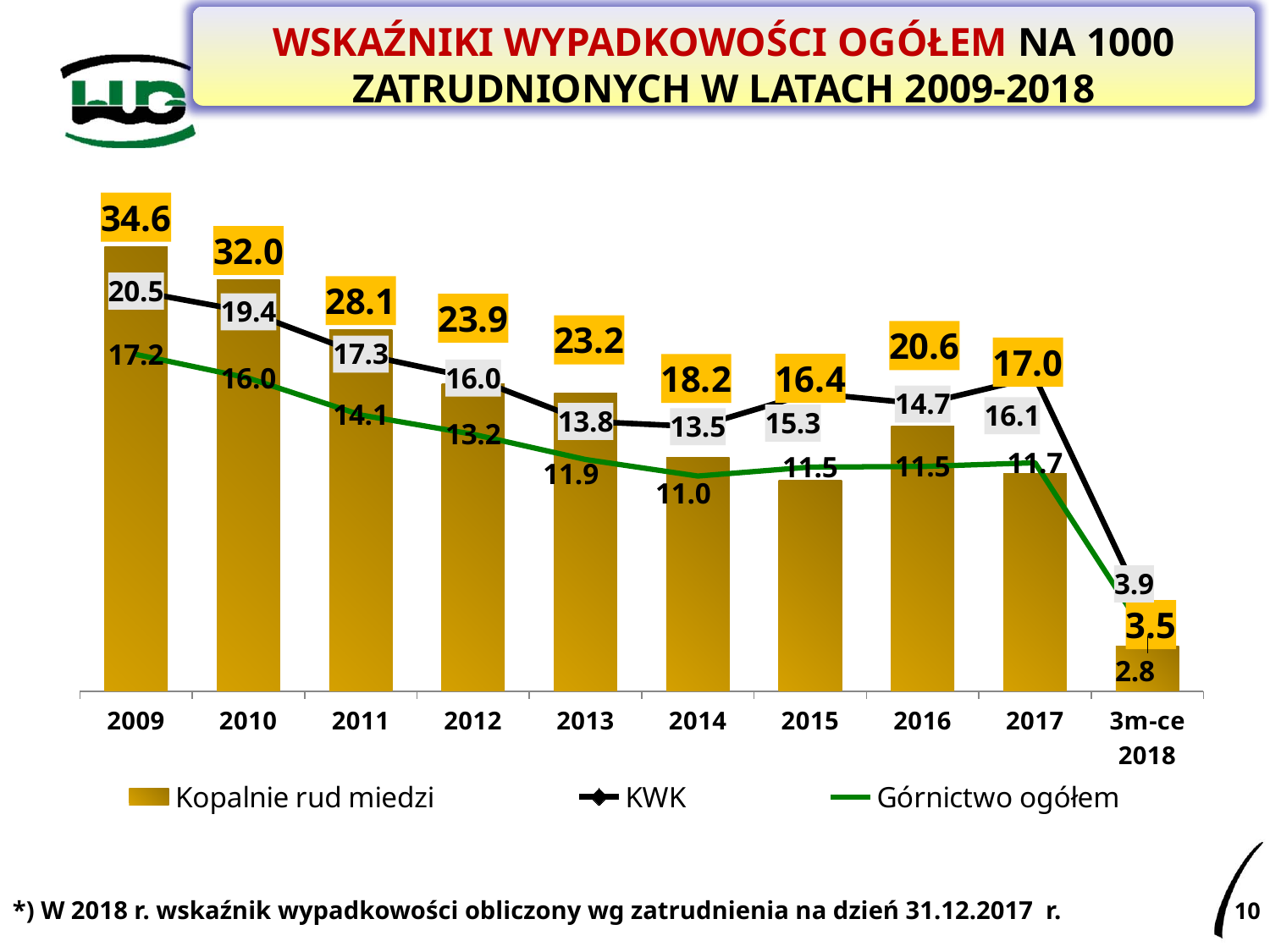
What is the difference between the Kopalnie rud miedzi values in 2009 and 2010? 2.6 What is the value for Kopalnie rud miedzi for 3m-ce 2018? 3.5 What is the KWK value in 2013? 13.8 How many series does the legend list? 3 What kind of chart is this? Combined bar and line chart Which is larger in 2016: the Kopalnie rud miedzi value or the KWK value? Kopalnie rud miedzi In which year is the Kopalnie rud miedzi value highest? 2009 Does the Górnictwo ogółem series generally rise or fall from 2009 to 2014? Fall Which category has the lowest KWK value? 3m-ce 2018 What is the value for Kopalnie rud miedzi in 2009? 34.6 How many categories are shown on the x axis? 10 What is the Górnictwo ogółem value in 2014? 11.0